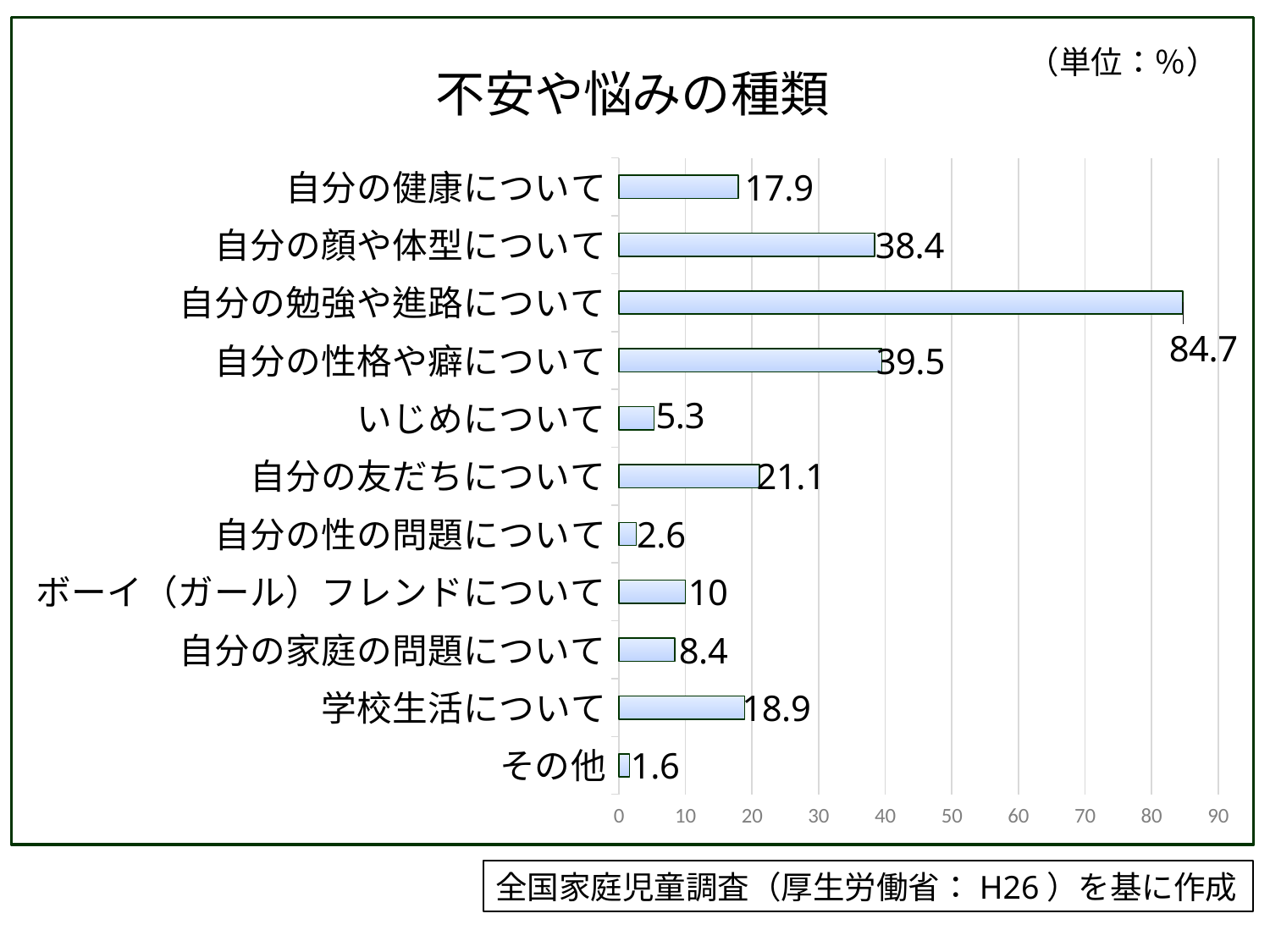
What is the value for ボーイ（ガール）フレンドについて? 10 What is the difference between the values for 自分の性格や癖について and 自分の顔や体型について? 1.1 What is the value for 自分の勉強や進路について? 84.7 What is the title of the chart? 不安や悩みの種類 Which category has the lowest value? その他 What is the value for いじめについて? 5.3 How many categories are shown in the chart? 11 Which category has the highest value? 自分の勉強や進路について Is the value for 自分の健康について greater or less than 20? less What kind of chart is shown on the slide? bar chart Which is larger, the value for 自分の友だちについて or the value for 学校生活について? 自分の友だちについて What unit is indicated for the chart values? %